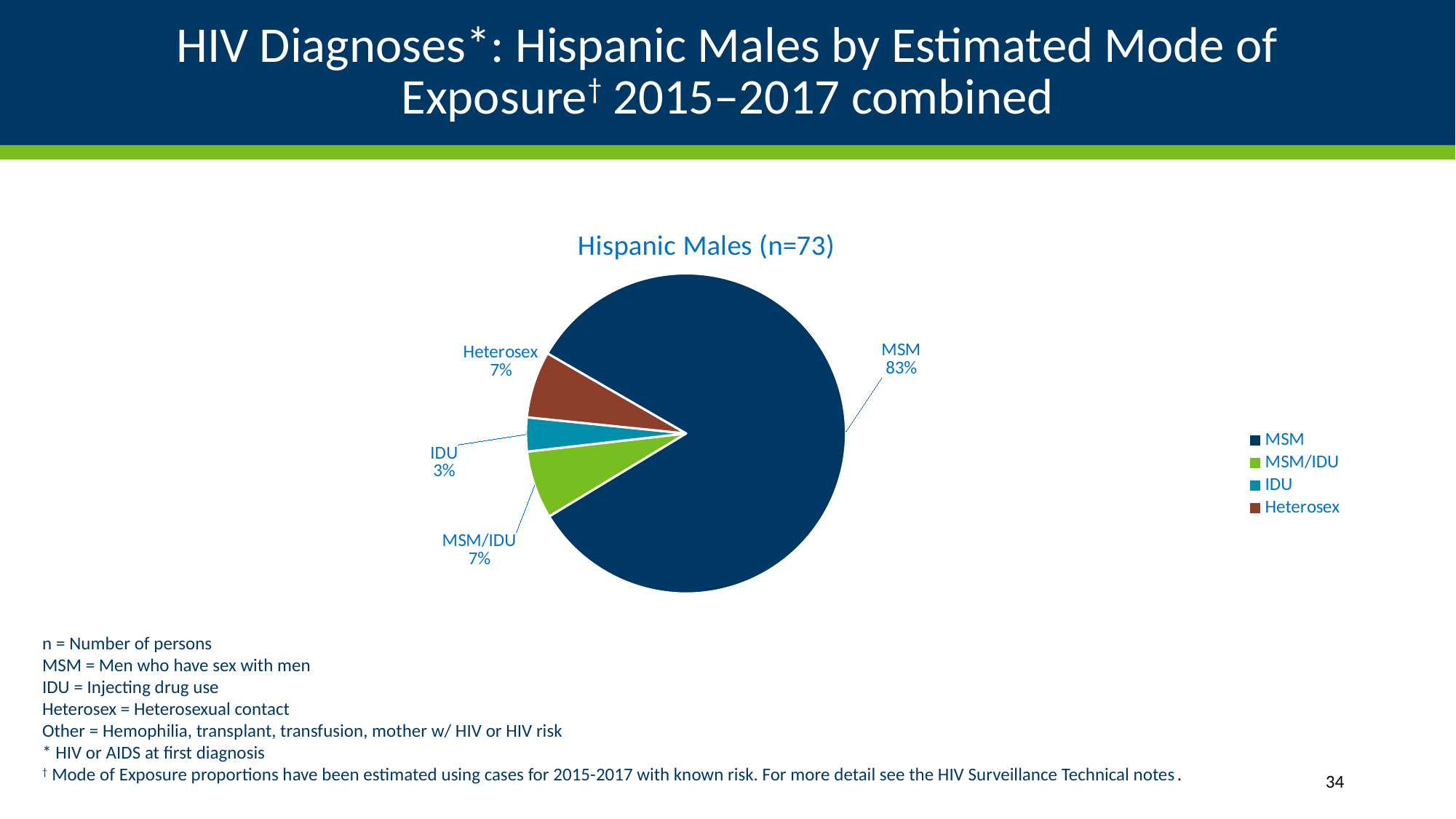
What percentage is shown for MSM/IDU? 7% How many slices does the pie chart have? 4 What percentage is shown for IDU? 3% What percentage is shown for Heterosex? 7% What is the title of the pie chart? Hispanic Males (n=73) What is the difference in percentage points between MSM and Heterosex? 76 Which is larger, the slice for IDU or the slice for Heterosex? Heterosex What share of the pie does MSM account for? 83% What kind of chart is shown on the slide? pie chart Which mode of exposure has the largest slice? MSM Which mode of exposure has the smallest slice? IDU How many entries does the legend list? 4